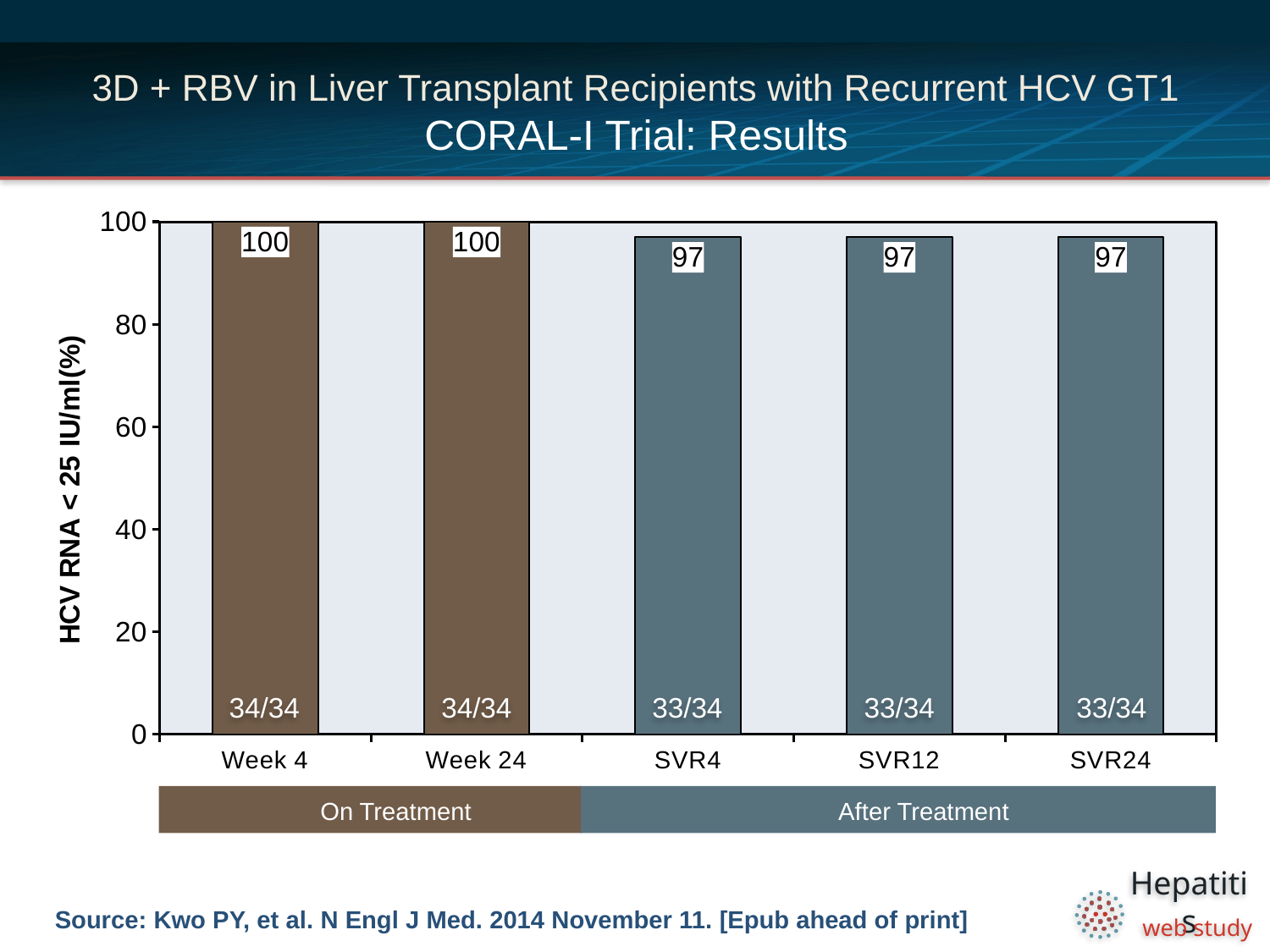
What is the value for SVR24? 97 What is the label of the y axis? HCV RNA < 25 IU/ml(%) What is the difference between the value for Week 24 and the value for SVR4? 3 What kind of chart is shown on the slide? bar chart What fraction of patients is shown inside the Week 24 bar? 34/34 What is the value for Week 4? 100 Which categories are grouped under the 'On Treatment' band below the x axis? Week 4 and Week 24 Which is larger, the value for Week 4 or the value for SVR12? Week 4 What fraction of patients is shown inside the SVR4 bar? 33/34 How many categories are shown on the x axis? 5 Is the value for SVR24 greater or less than 80? greater What is the value for SVR12? 97